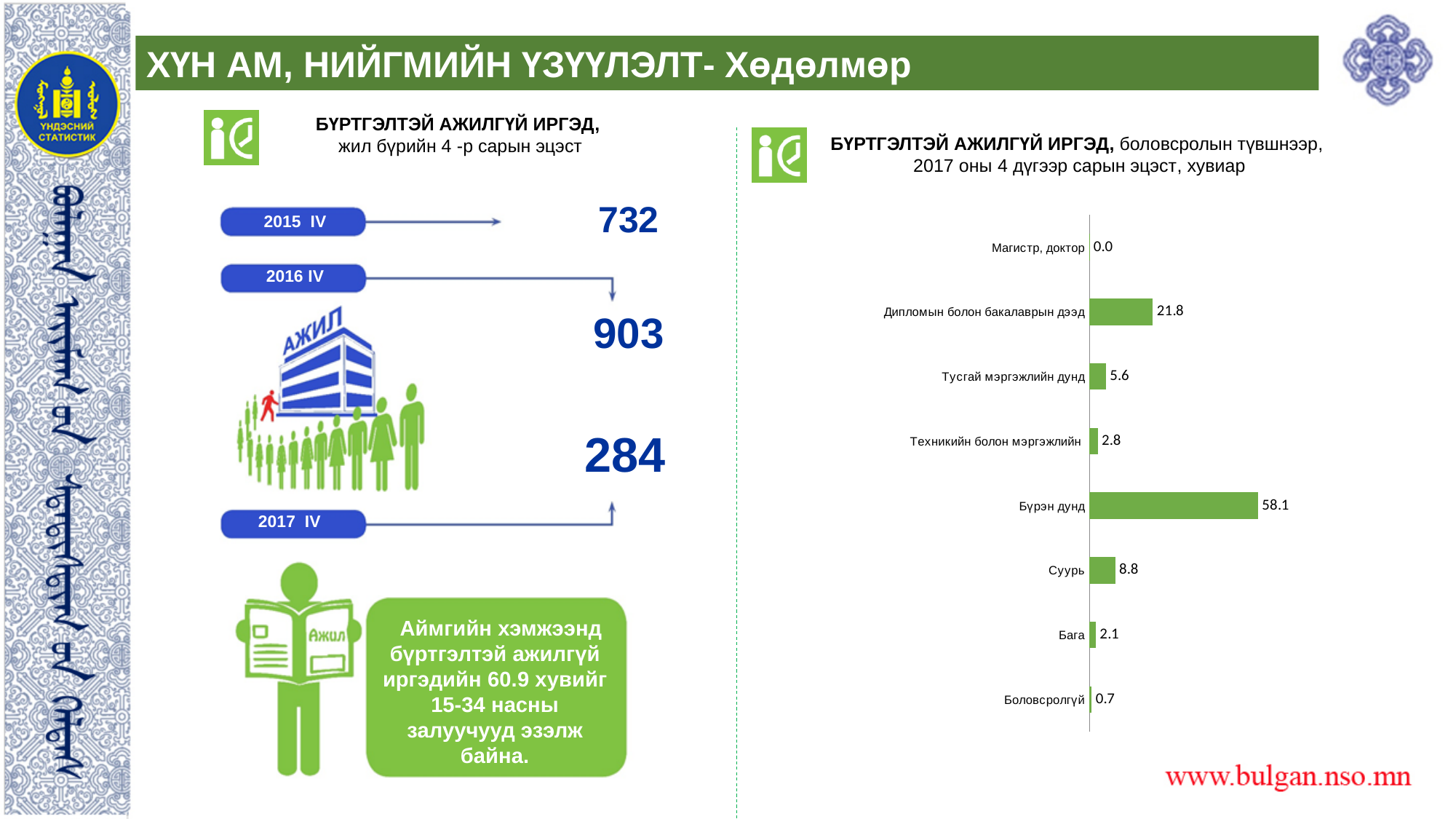
In the bar chart on the right, which is larger: the value for Тусгай мэргэжлийн дунд or the value for Техникийн болон мэргэжлийн? Тусгай мэргэжлийн дунд In the bar chart on the right, what is the difference between the values for Бүрэн дунд and Дипломын болон бакалаврын дээд? 36.3 What colour are the bars in the chart on the right? Green In the bar chart on the right, what is the value for Дипломын болон бакалаврын дээд? 21.8 How many education-level categories are shown in the bar chart on the right? 8 In the bar chart on the right, what is the value for Бүрэн дунд? 58.1 What type of chart is shown on the right side of the slide? Bar chart In the bar chart on the right, what is the value for Боловсролгүй? 0.7 In the bar chart on the right, which education level has the lowest value? Магистр, доктор In the bar chart on the right, which education level has the highest value? Бүрэн дунд In the bar chart on the right, what is the value for Суурь? 8.8 In the bar chart on the right, what is the difference between the values for Суурь and Бага? 6.7